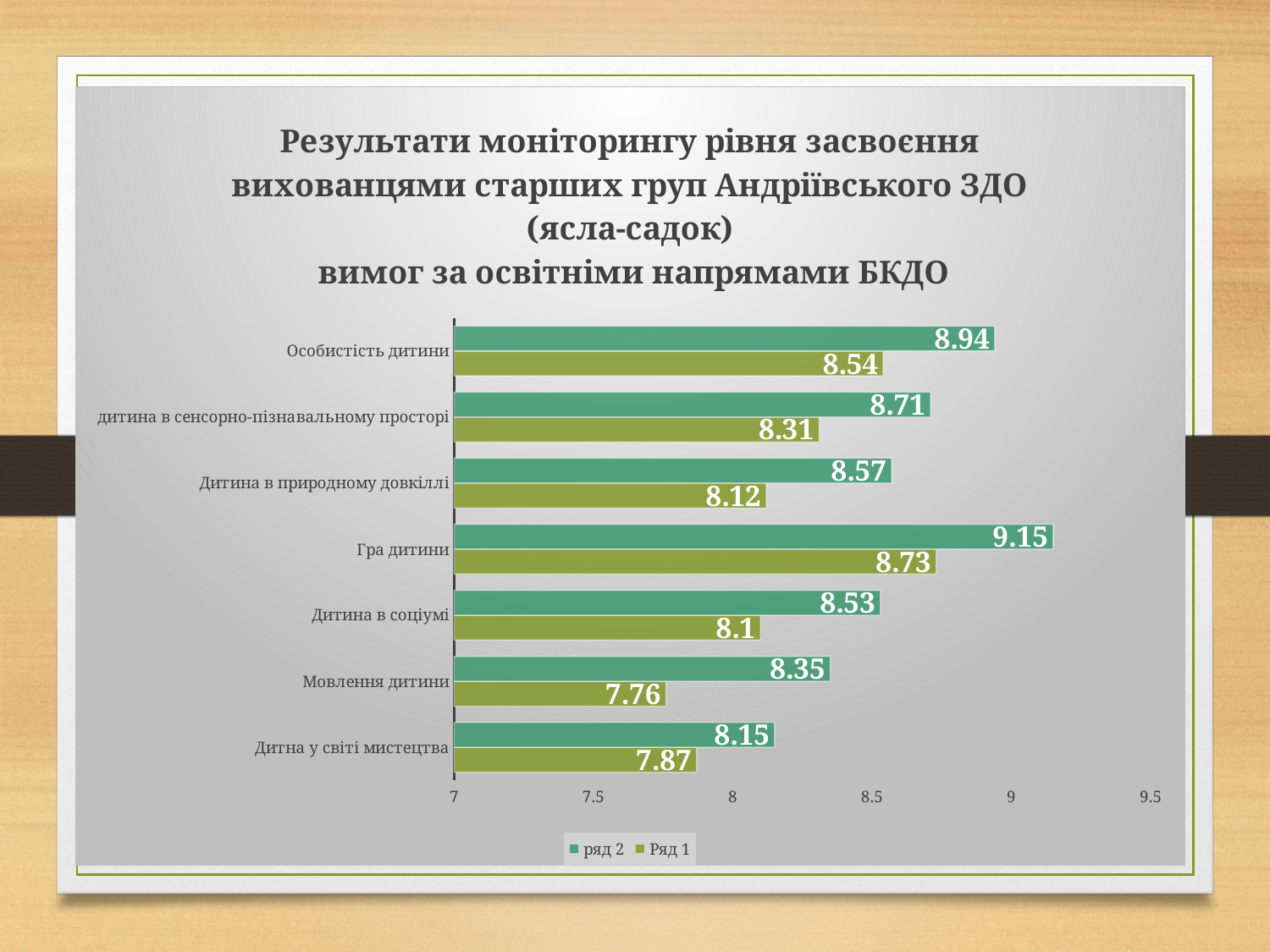
How many series does the legend list? 2 Is the ряд 2 value for Мовлення дитини greater or less than 8.5? less What is the value of Ряд 1 for Мовлення дитини? 7.76 What is the value of ряд 2 for Гра дитини? 9.15 Which category has the lowest value for Ряд 1? Мовлення дитини What is the value of Ряд 1 for Особистість дитини? 8.54 How many categories are shown on the chart? 7 What is the difference between ряд 2 and Ряд 1 for Дитина в природному довкіллі? 0.45 What are the two series names listed in the legend? ряд 2 and Ряд 1 What type of chart is shown on the slide? bar chart Which is larger: the Ряд 1 value for Дитина в соціумі or the Ряд 1 value for Дитна у світі мистецтва? Дитина в соціумі Which category has the highest value for ряд 2? Гра дитини